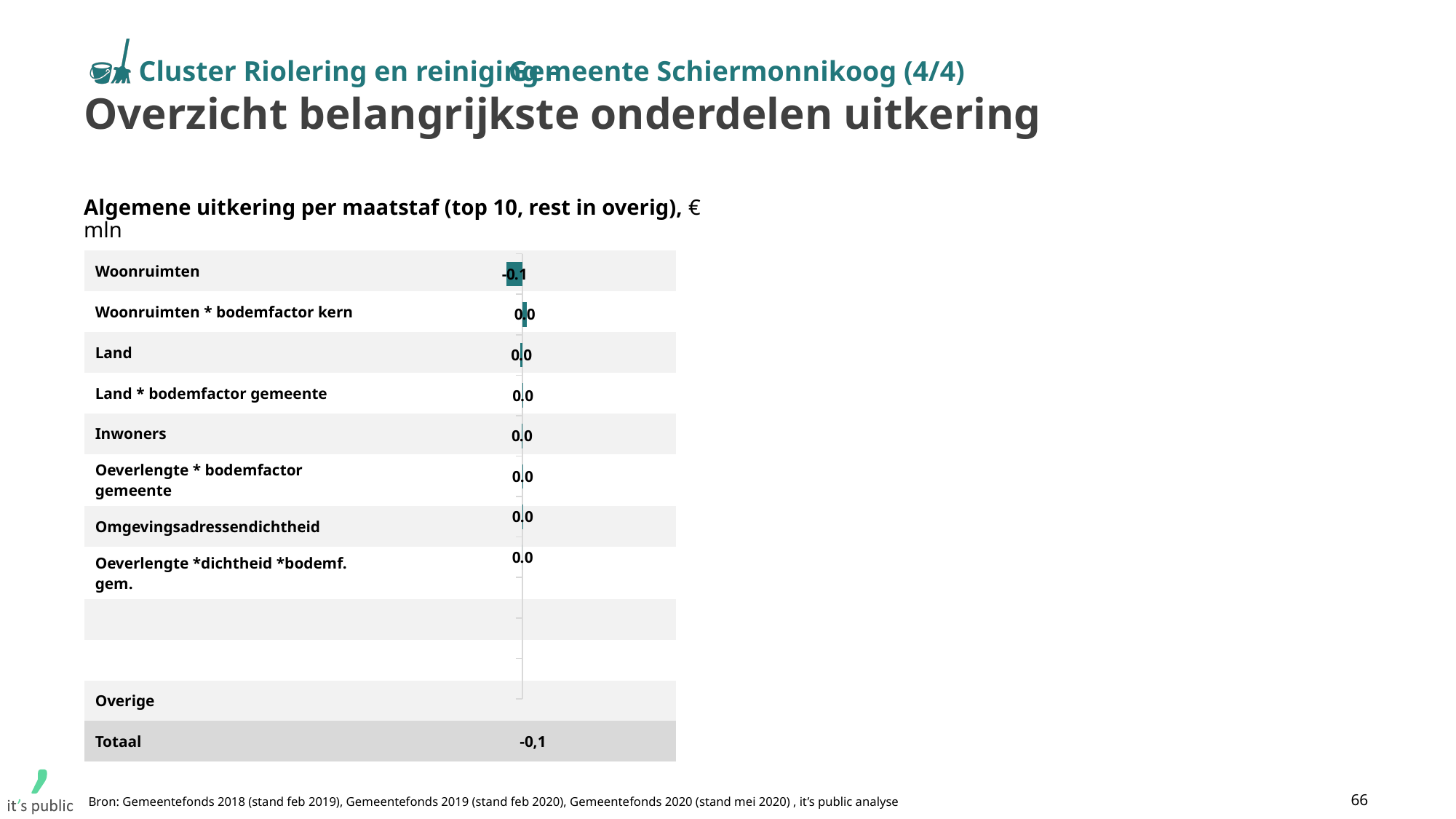
What is the value for Woonruimten? -0.1 How many categories have a printed value of 0.0? 7 What is the value for Land? 0.0 Which is larger, the value for Woonruimten or the value for Land? Land What is the title of the chart? Algemene uitkering per maatstaf (top 10, rest in overig), € mln What is the difference between the value for Land and the value for Woonruimten? 0.1 Which category has the lowest value? Woonruimten What is the value shown in the Totaal row? -0,1 What kind of chart is shown on the slide? Bar chart What is the value for Inwoners? 0.0 What is the value shown for Omgevingsadressendichtheid? 0.0 In what unit are the chart values expressed? € mln